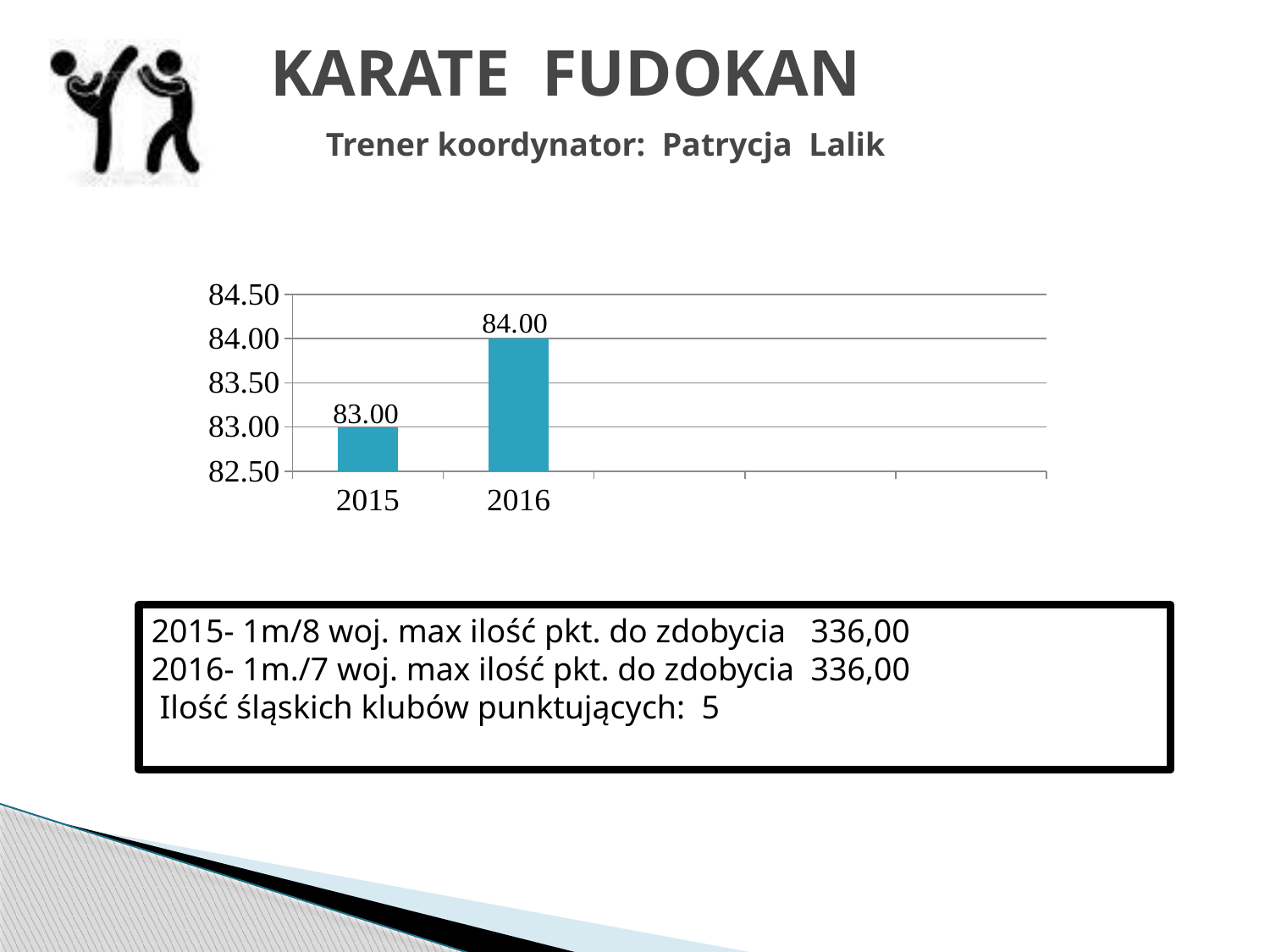
Do the values rise or fall from 2015 to 2016? rise Which year has the lowest value? 2015 What is the value for 2016? 84.00 What is the value for 2015? 83.00 How many bars are plotted in the chart? 2 What kind of chart is shown on the slide? bar chart What is the difference between the values for 2016 and 2015? 1.00 Which year has the highest value? 2016 Which is larger, the value for 2015 or the value for 2016? 2016 Is the value for 2015 greater or less than 83.50? less What is the lowest value shown on the vertical axis? 82.50 Is the value for 2016 greater or less than 83.50? greater